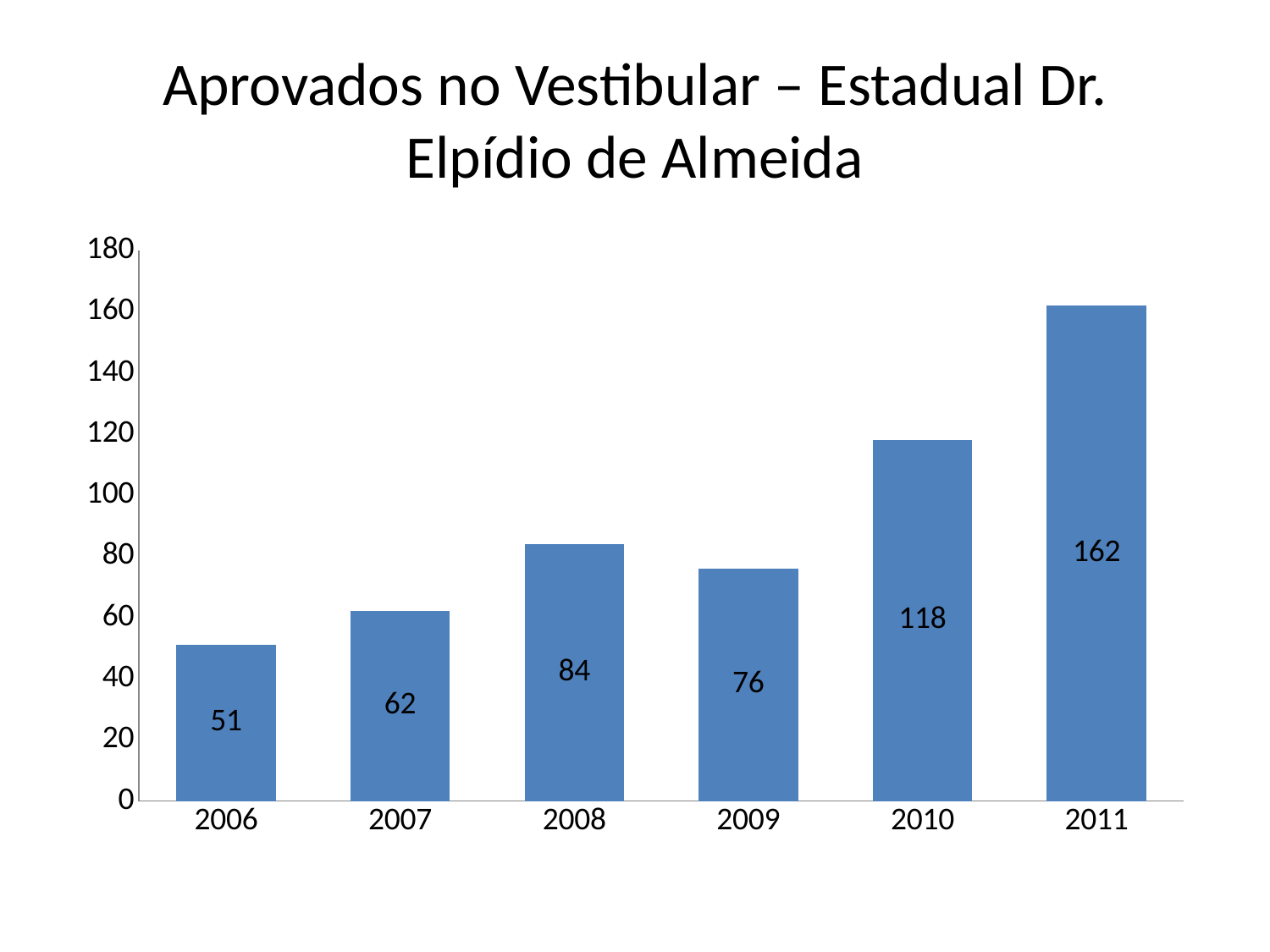
Is the value for 2010 greater or less than 100? greater How many years are shown on the x axis? 6 What is the title of the slide? Aprovados no Vestibular – Estadual Dr. Elpídio de Almeida Which year has the lowest value? 2006 What is the value for 2011? 162 What kind of chart is shown on the slide? bar chart What is the difference between the values for 2008 and 2009? 8 What is the value for 2006? 51 What is the value for 2009? 76 Which year has the highest value? 2011 Which is larger, the value for 2008 or the value for 2009? 2008 What is the difference between the values for 2011 and 2010? 44